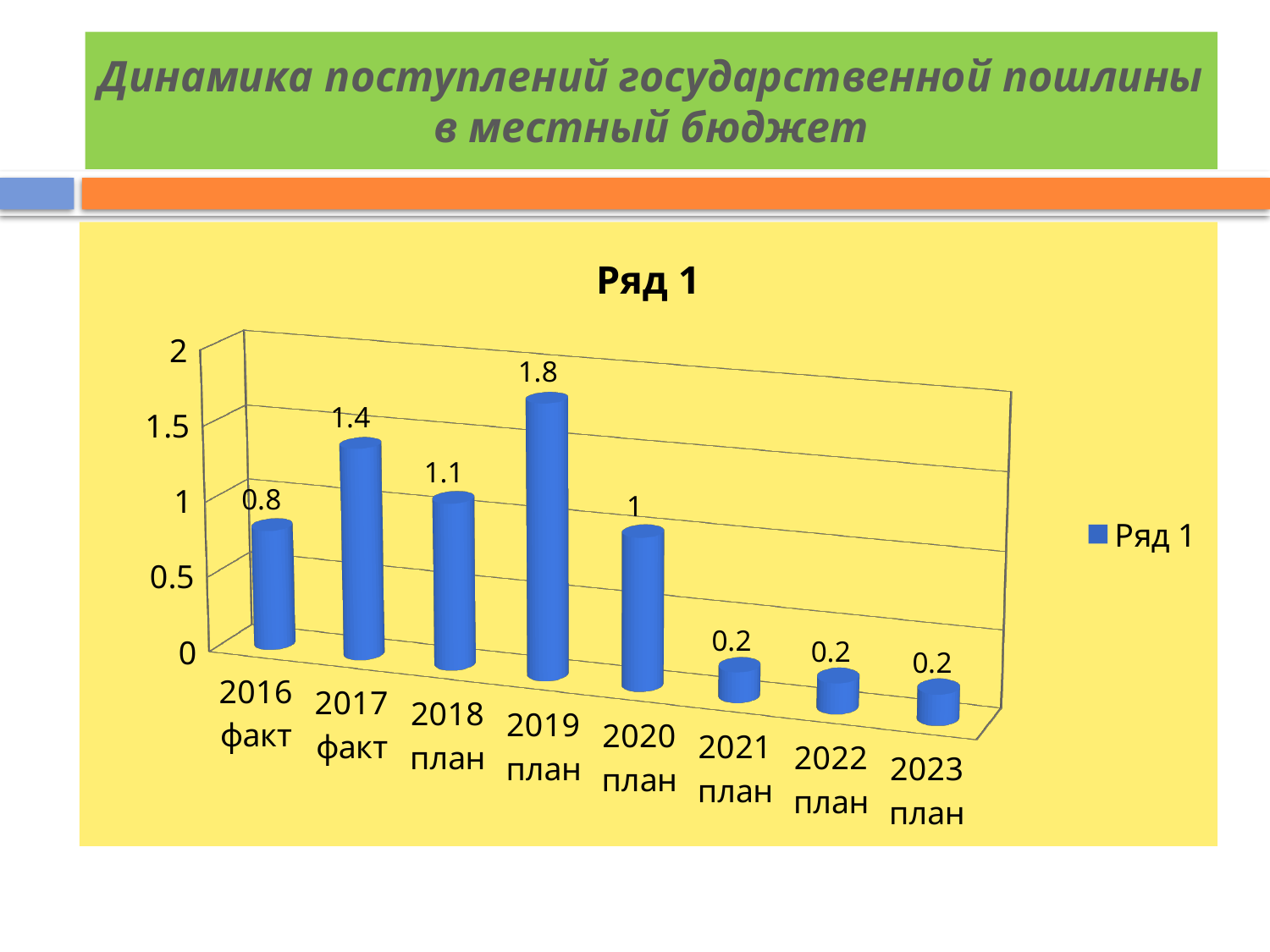
What is the value for 2022 план? 0.2 What is the value for 2020 план? 1 What is the difference between the values for 2019 план and 2017 факт? 0.4 How many series does the legend list? 1 Which is larger, the value for 2018 план or the value for 2020 план? 2018 план What is the value for 2019 план? 1.8 What kind of chart is shown on the slide? bar chart What is the title of the chart? Ряд 1 Do the values rise or fall from 2019 план to 2023 план? fall How many categories are shown on the x axis? 8 What is the value for 2016 факт? 0.8 Which category has the highest value? 2019 план